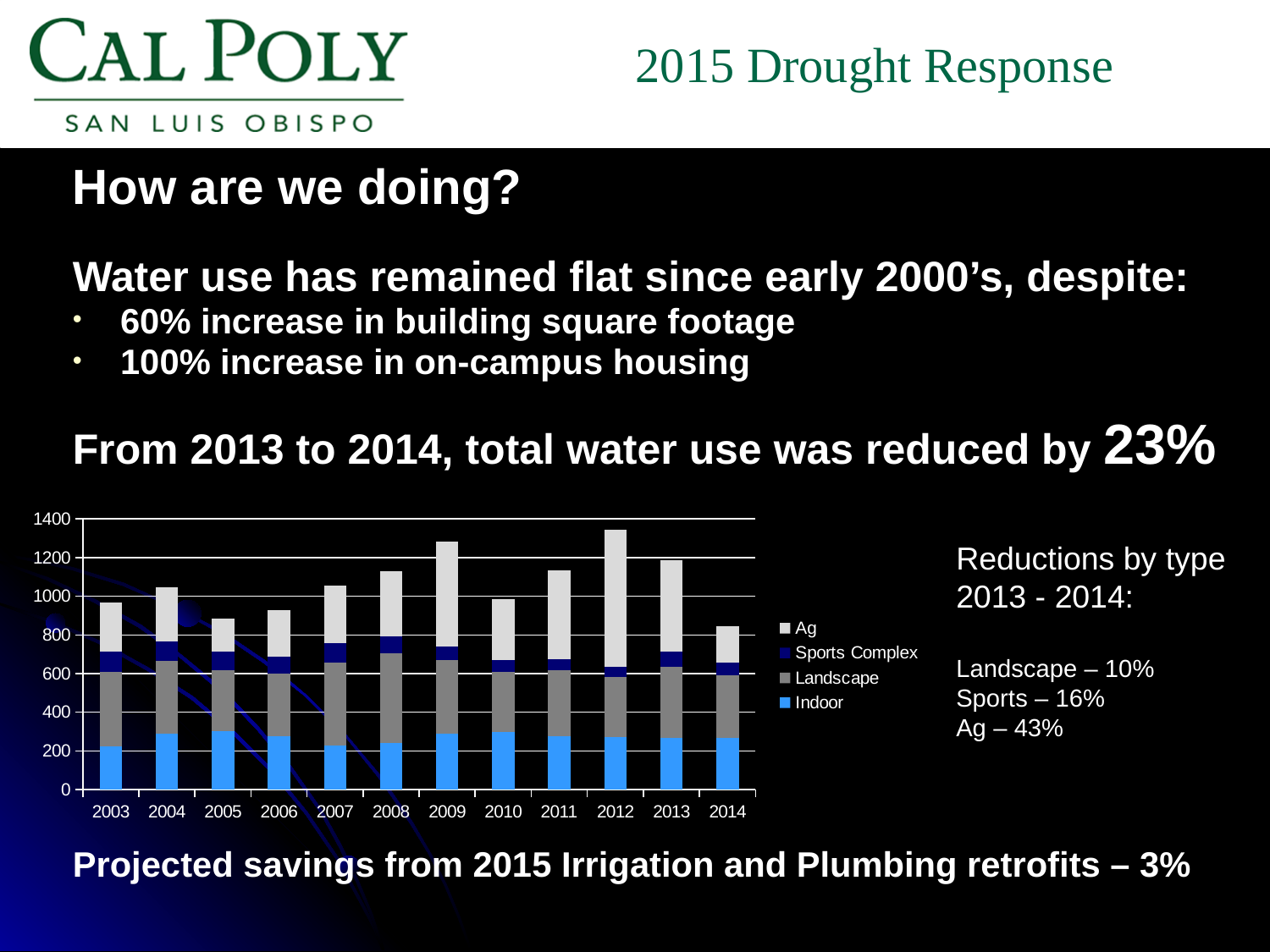
Which year has the tallest stacked bar in the chart? 2012 Which series is listed first in the chart's legend? Ag What kind of chart is shown on the slide? stacked bar chart Which year has the larger total bar, 2012 or 2014? 2012 Does the total bar height rise or fall from 2013 to 2014? fall How many series does the chart's legend list? 4 How many years are shown along the x axis of the chart? 12 Is the total for 2012 greater or less than 1200? greater Is the total for 2014 greater or less than 1000? less Which year has the larger total bar, 2009 or 2010? 2009 Is the total for 2009 greater or less than 1200? greater